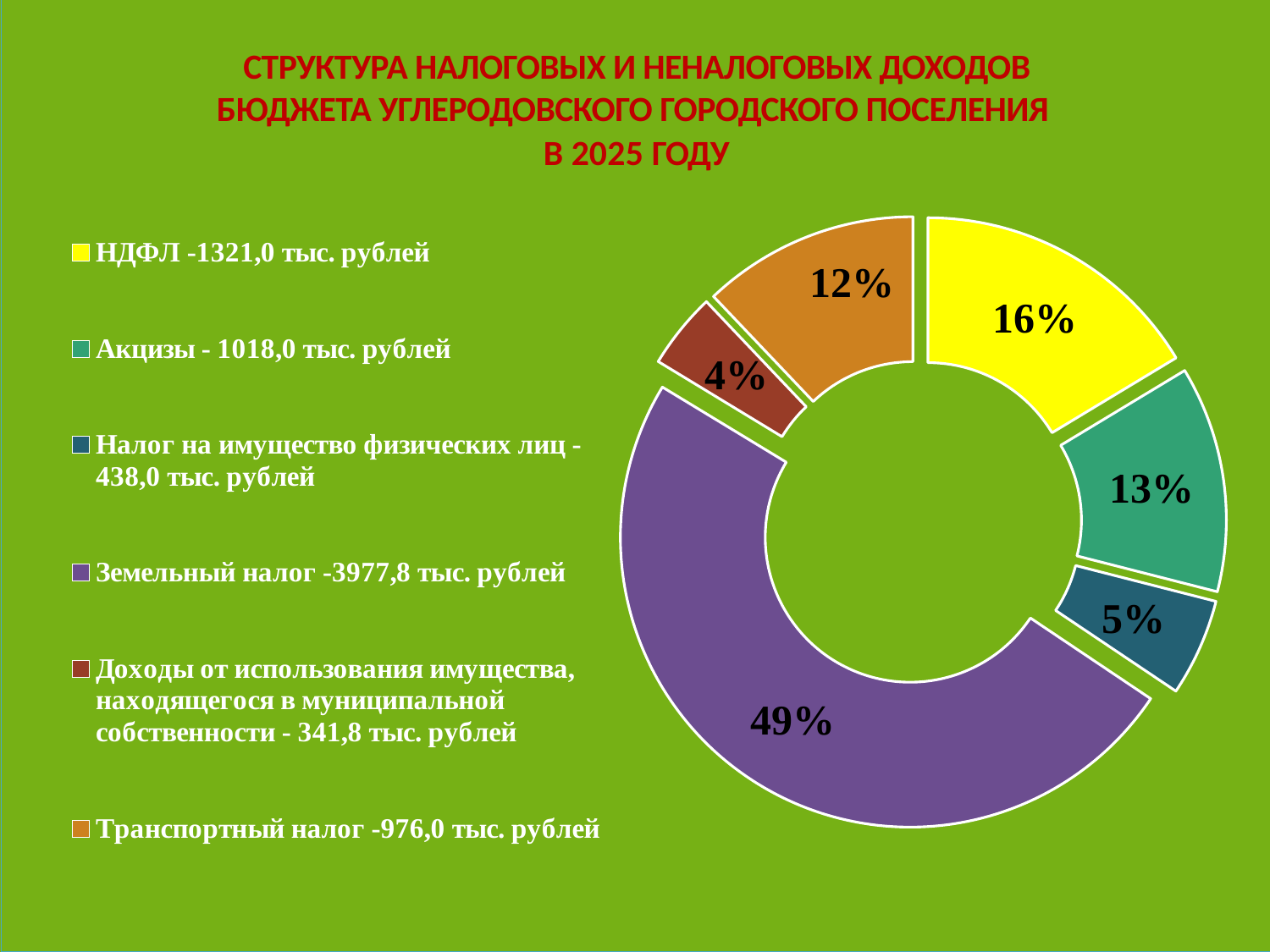
What is the difference in percentage points between the share of Земельный налог and the share of НДФЛ? 33 percentage points What share of the pie does НДФЛ account for? 16% What share of the pie does Налог на имущество физических лиц account for? 5% What share of the pie does Транспортный налог account for? 12% According to the legend, what amount in thousand rubles is given for Земельный налог? 3977,8 тыс. рублей Which has the larger share: Акцизы or Транспортный налог? Акцизы How many slices does the pie chart have? 6 Which category has the largest share of the pie? Земельный налог What kind of chart is shown on the slide? Pie (doughnut) chart Which category has the smallest share of the pie? Доходы от использования имущества, находящегося в муниципальной собственности